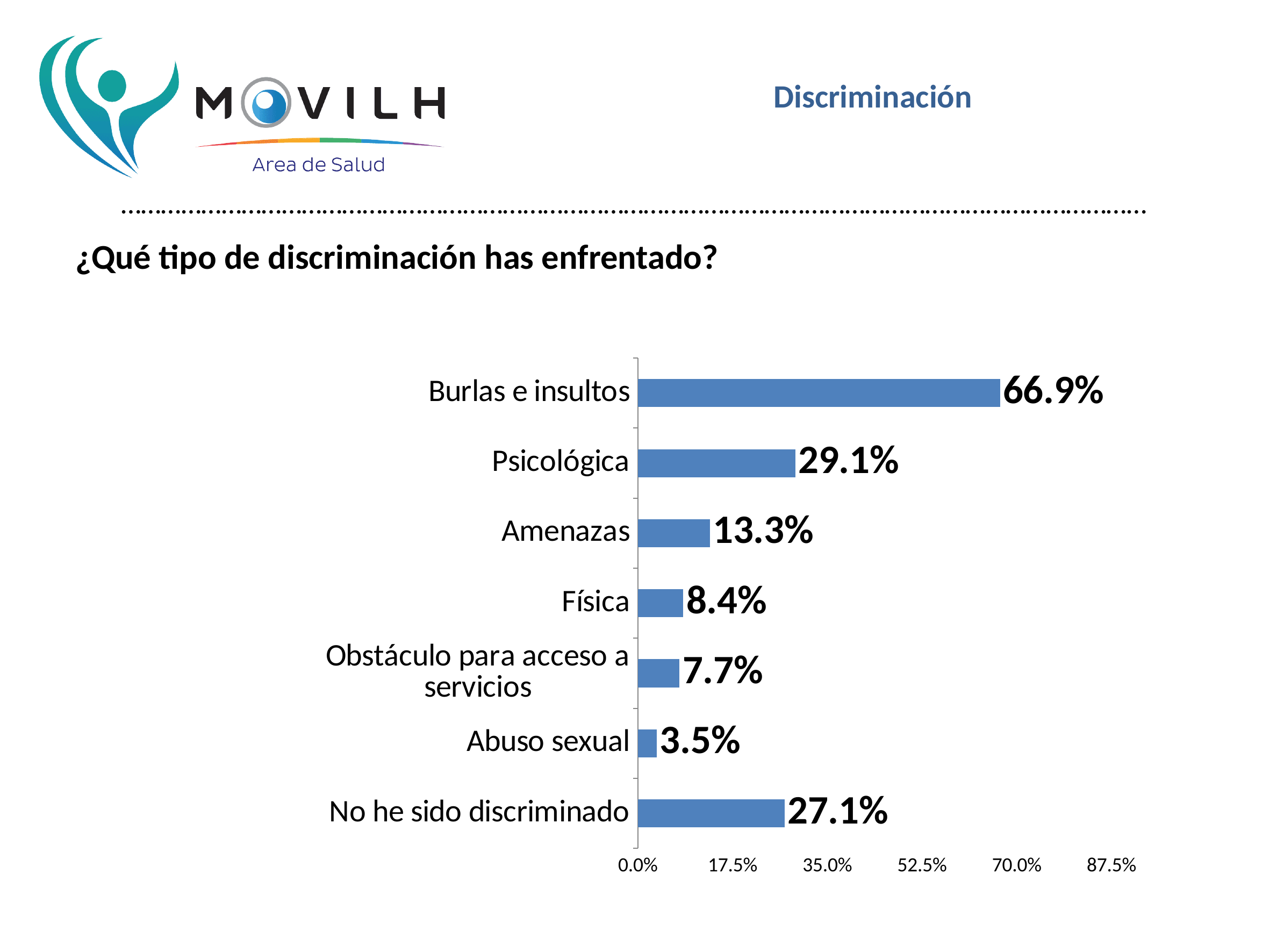
How many categories are shown in the chart? 7 Which is larger, Amenazas or Física? Amenazas What is the value for Obstáculo para acceso a servicios? 7.7% What kind of chart is shown on the slide? Bar chart What is the value for Psicológica? 29.1% Which category has the lowest value? Abuso sexual What question is the chart answering, as shown in the heading above it? ¿Qué tipo de discriminación has enfrentado? What is the value for No he sido discriminado? 27.1% What is the value for Burlas e insultos? 66.9% What is the difference between Burlas e insultos and Psicológica? 37.8% Which category has the highest value? Burlas e insultos Is the value for Psicológica greater or less than 35.0%? less